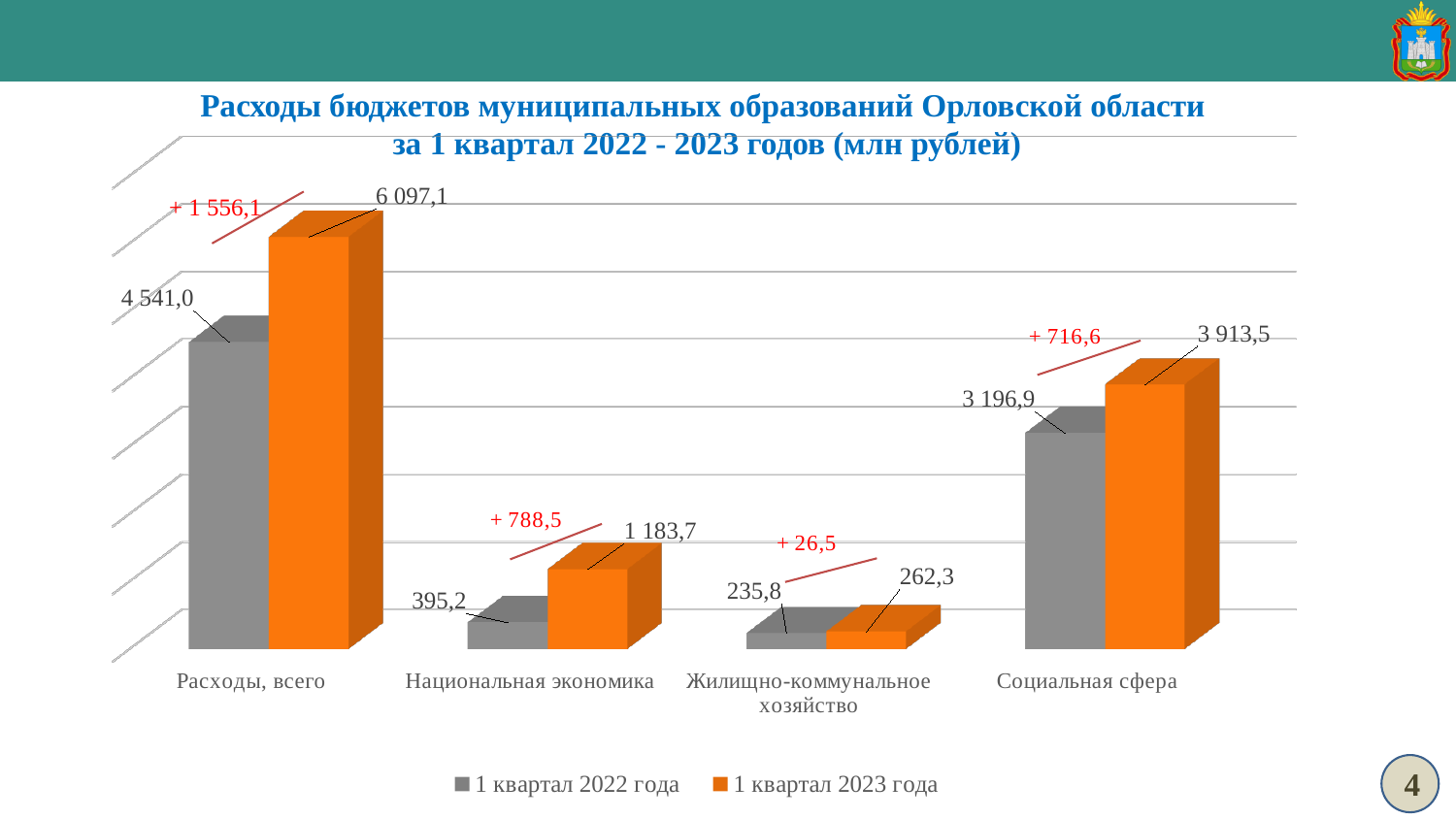
Which category has the lowest value in 1 квартал 2022 года? Жилищно-коммунальное хозяйство What kind of chart is shown on the slide? Bar chart What is the value for Жилищно-коммунальное хозяйство in 1 квартал 2023 года? 262,3 How many categories are shown on the x axis? 4 What is the value for Национальная экономика in 1 квартал 2022 года? 395,2 What is the difference between the 1 квартал 2023 года and 1 квартал 2022 года values for Национальная экономика? 788,5 Which category has the highest value in 1 квартал 2023 года? Расходы, всего What is the difference between the 1 квартал 2023 года and 1 квартал 2022 года values for Социальная сфера? 716,6 What is the value for Социальная сфера in 1 квартал 2022 года? 3 196,9 Which is larger for Жилищно-коммунальное хозяйство: the 1 квартал 2022 года value or the 1 квартал 2023 года value? 1 квартал 2023 года What is the value for Расходы, всего in 1 квартал 2023 года? 6 097,1 How many series does the legend list? 2